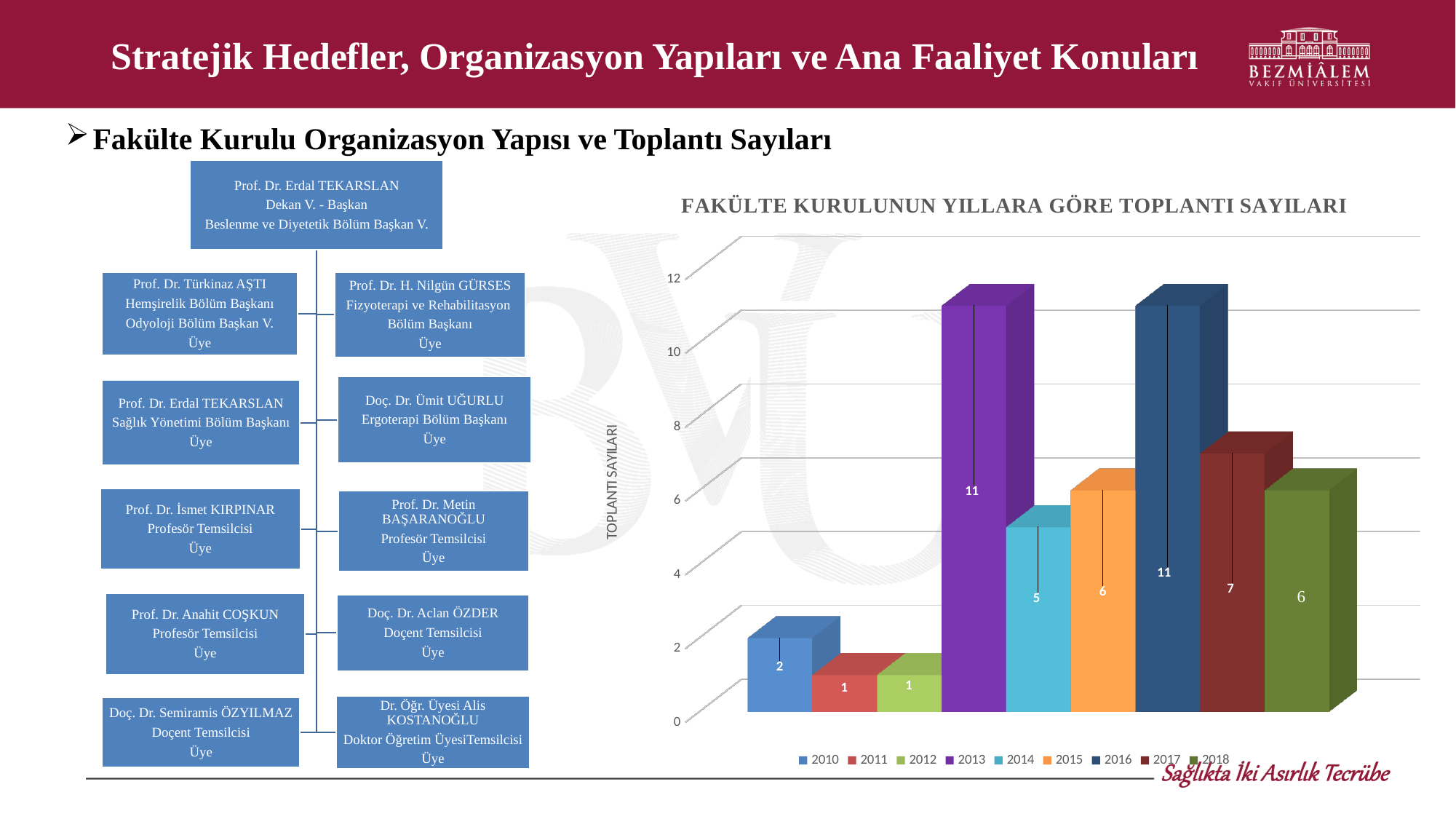
Is the value for 2013 greater or less than 10? greater What is the value for 2014 in the chart? 5 What kind of chart is shown on the slide? bar chart How many entries does the chart legend list? 9 What is the value for 2017 in the chart? 7 How many years are shown in the chart? 9 What is the value for 2013 in the chart? 11 What is the value for 2010 in the chart? 2 Which is larger, the value for 2017 or the value for 2018? 2017 What is the title of the chart? FAKÜLTE KURULUNUN YILLARA GÖRE TOPLANTI SAYILARI Which year has the lowest value in the chart? 2011 and 2012 What is the difference between the values for 2016 and 2015? 5